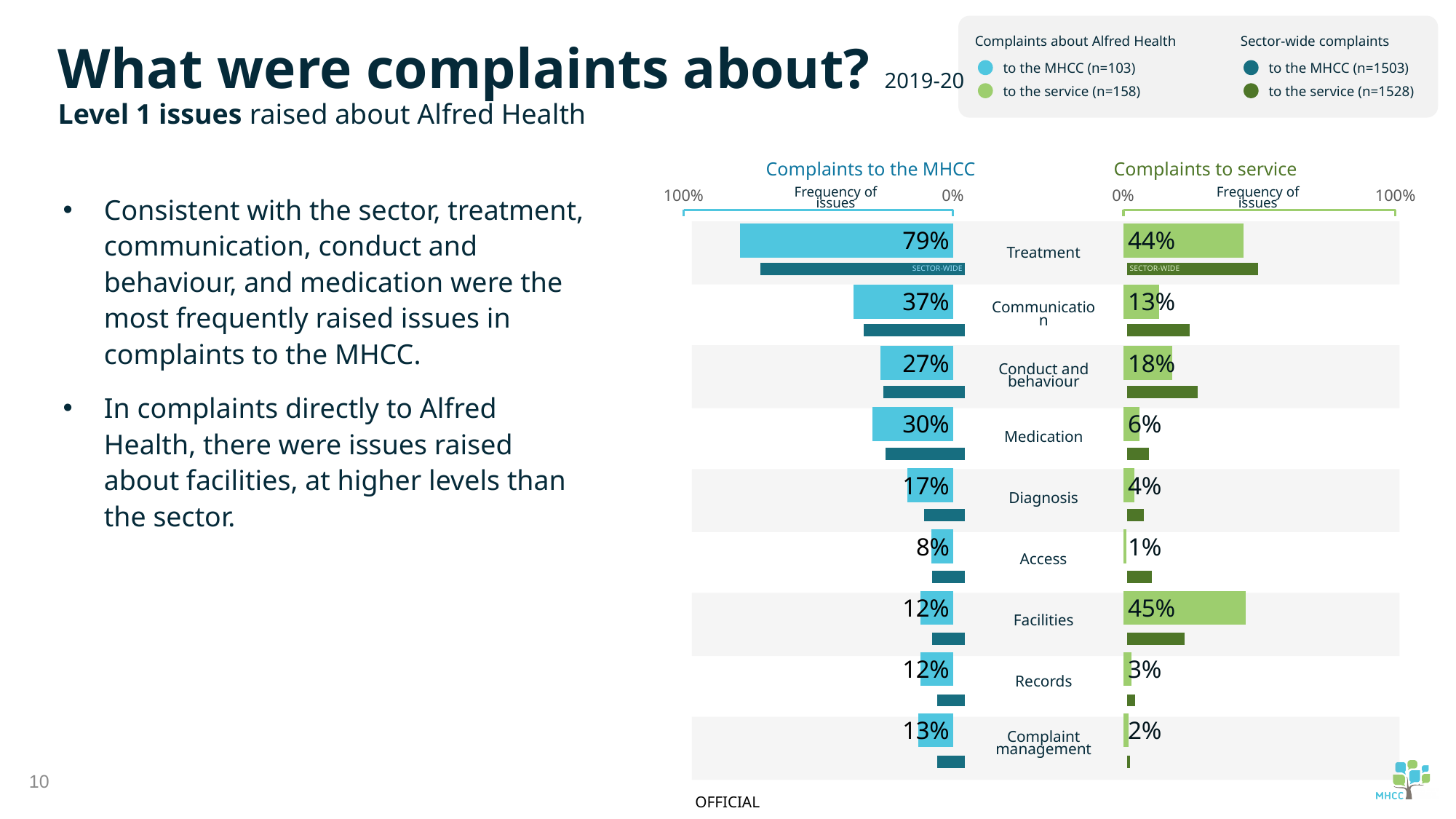
In the Complaints to the MHCC chart, what percentage of complaints raised Treatment as an issue? 79% How many issue categories are shown in the chart? 9 In the Complaints to the MHCC chart, which issue has the highest frequency? Treatment In the Complaints to the MHCC chart, which is larger: Communication or Medication? Communication In the Complaints to service chart, which issue has the lowest frequency? Access What type of chart is shown on the slide? Bar chart How many series does the legend list? 4 In the Complaints to the MHCC chart, which issue has the lowest frequency? Access In the Complaints to service chart, what is the value for Medication? 6% What is the difference between the Treatment value in the Complaints to the MHCC chart and the Treatment value in the Complaints to service chart? 35% In the Complaints to service chart, what is the value for Facilities? 45% In the Complaints to service chart, which is larger: Facilities or Treatment? Facilities